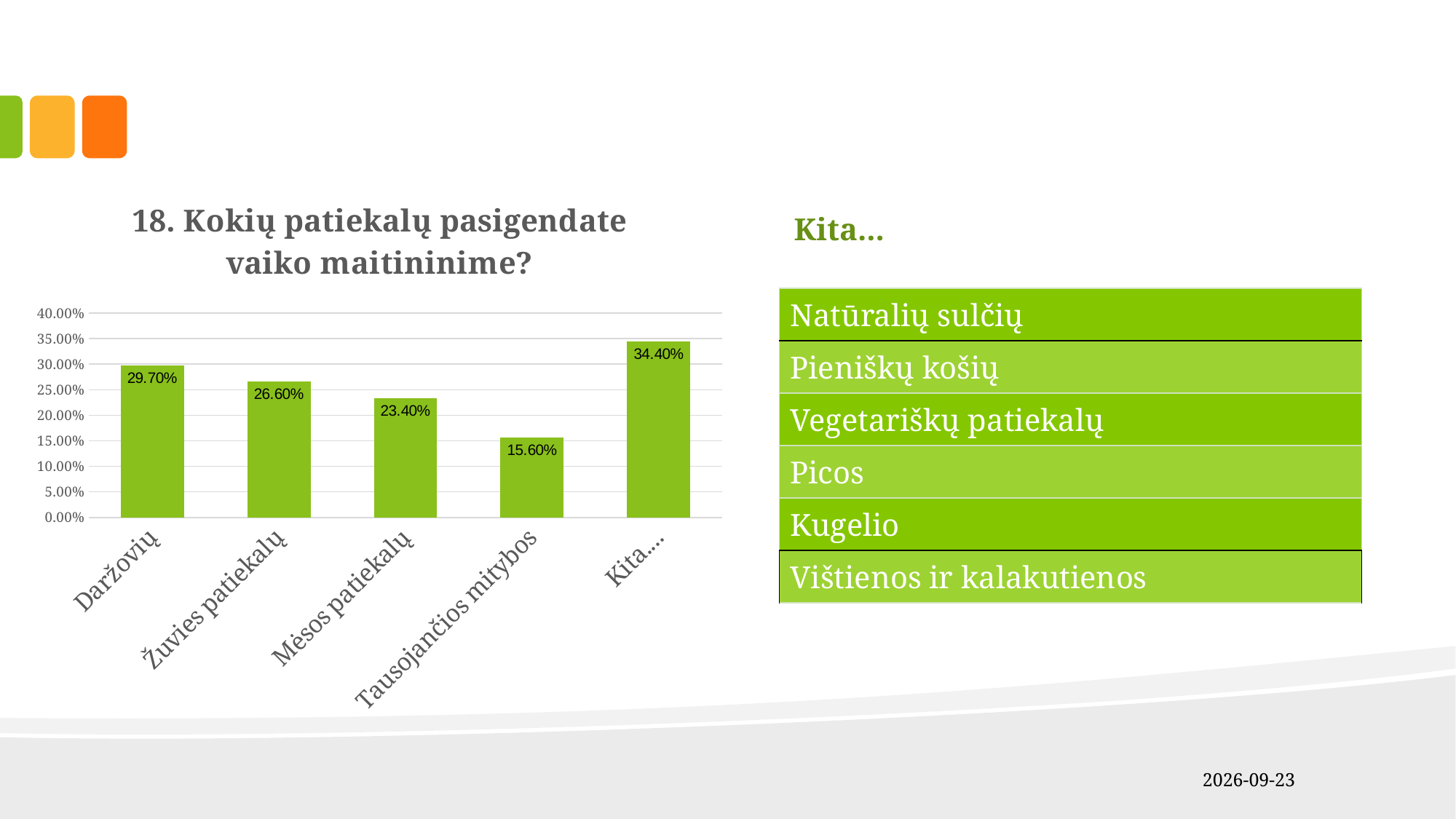
What is the value for Daržovių? 29.70% What kind of chart is shown on the slide? bar chart How many categories are shown on the x axis of the chart? 5 What is the value for Tausojančios mitybos? 15.60% What is the title of the chart? 18. Kokių patiekalų pasigendate vaiko maitininime? What is the difference between the values for Daržovių and Tausojančios mitybos? 14.10% Which category has the lowest value? Tausojančios mitybos Is the value for Kita.... greater or less than 30.00%? greater Which category has the highest value? Kita.... Which is larger, the value for Žuvies patiekalų or the value for Mėsos patiekalų? Žuvies patiekalų What is the value for Mėsos patiekalų? 23.40% What is the value for Žuvies patiekalų? 26.60%